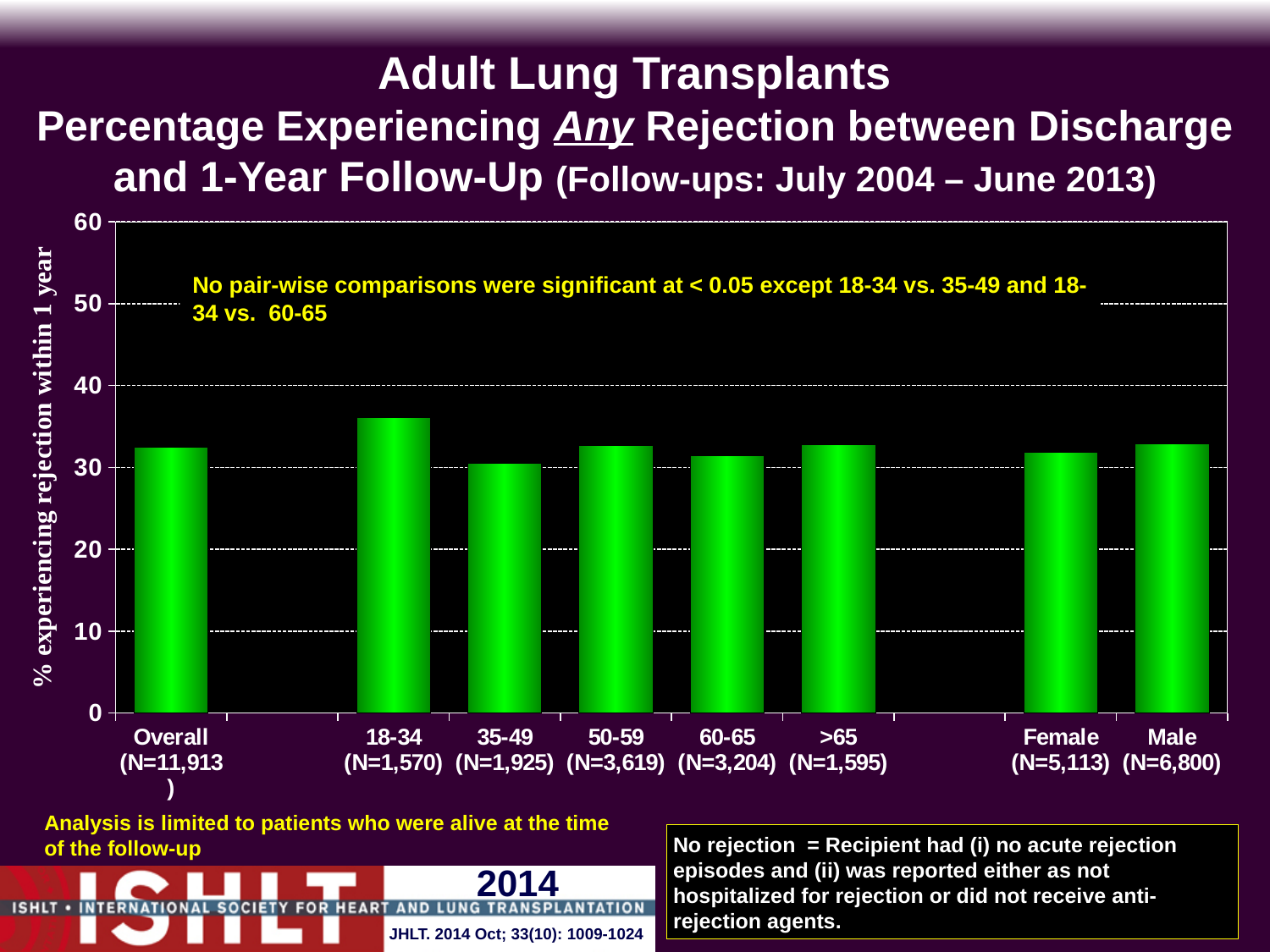
Which is larger, the value for 18-34 or the value for Overall? 18-34 Is the value for Overall greater or less than 30? greater What is the N shown for the Female category? N=5,113 Is the value for the 18-34 age group greater or less than 30? greater What kind of chart is shown on the slide? bar chart Is the value for >65 greater or less than 30? greater Which is larger, the value for 18-34 or the value for 35-49? 18-34 What is the label on the y-axis of the chart? % experiencing rejection within 1 year How many bars (categories) are plotted in the chart? 8 Which category has the highest percentage experiencing rejection within 1 year? 18-34